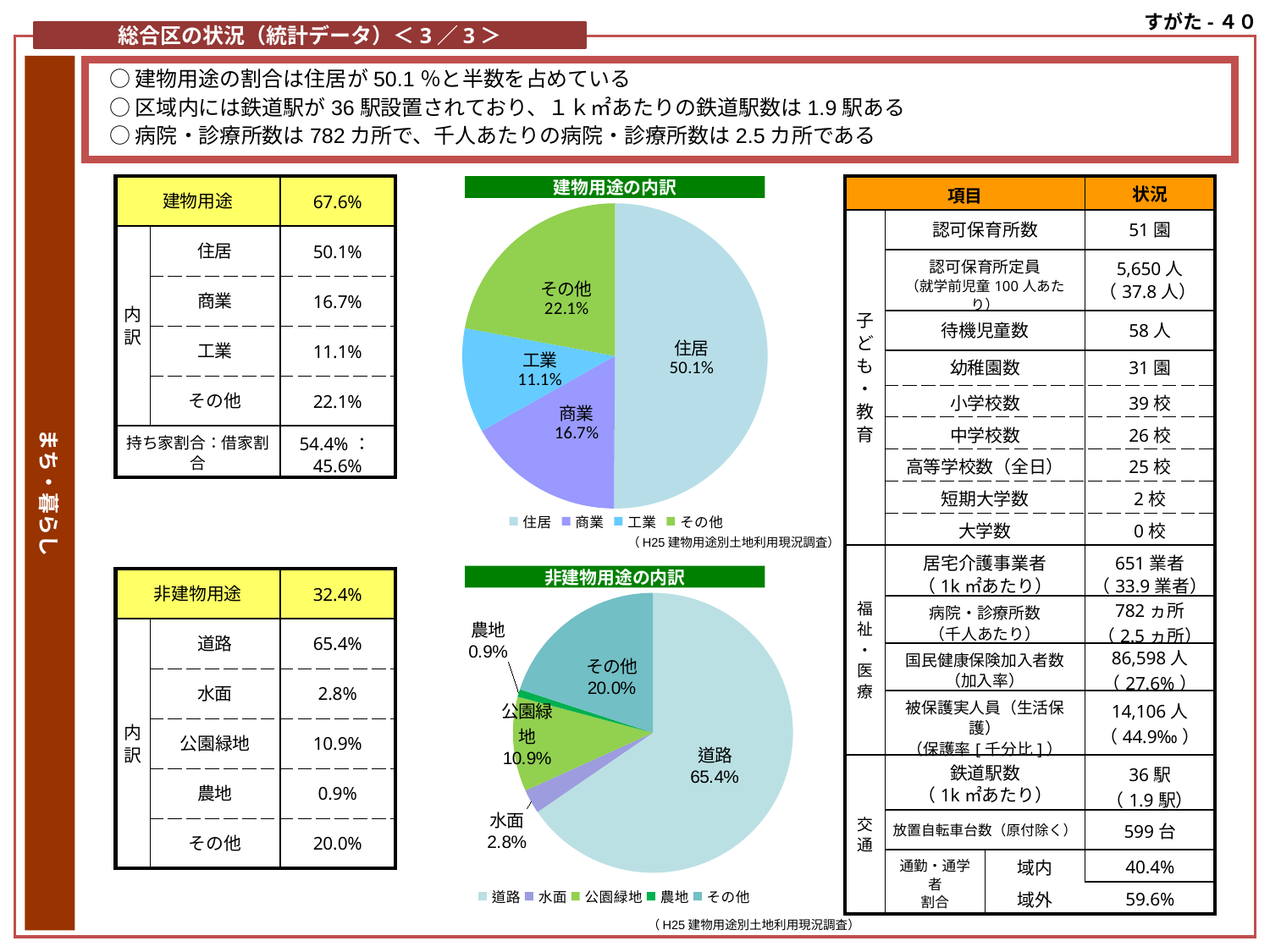
How many entries does the legend of the 非建物用途の内訳 chart list? 5 In the 建物用途の内訳 pie chart, what share does 住居 have? 50.1% In the 建物用途の内訳 pie chart, which category has the smallest share? 工業 How many slices does the 建物用途の内訳 pie chart have? 4 What type of chart is the 非建物用途の内訳 chart? Pie chart In the 建物用途の内訳 pie chart, what share does 工業 have? 11.1% In the 建物用途の内訳 pie chart, which category has the largest share? 住居 In the 非建物用途の内訳 pie chart, what share does 道路 have? 65.4% In the 建物用途の内訳 pie chart, what is the difference between the shares of その他 and 商業? 5.4% In the 非建物用途の内訳 pie chart, which is larger, 公園緑地 or 水面? 公園緑地 In the 非建物用途の内訳 pie chart, what share does 農地 have? 0.9% In the 非建物用途の内訳 pie chart, which category has the smallest share? 農地